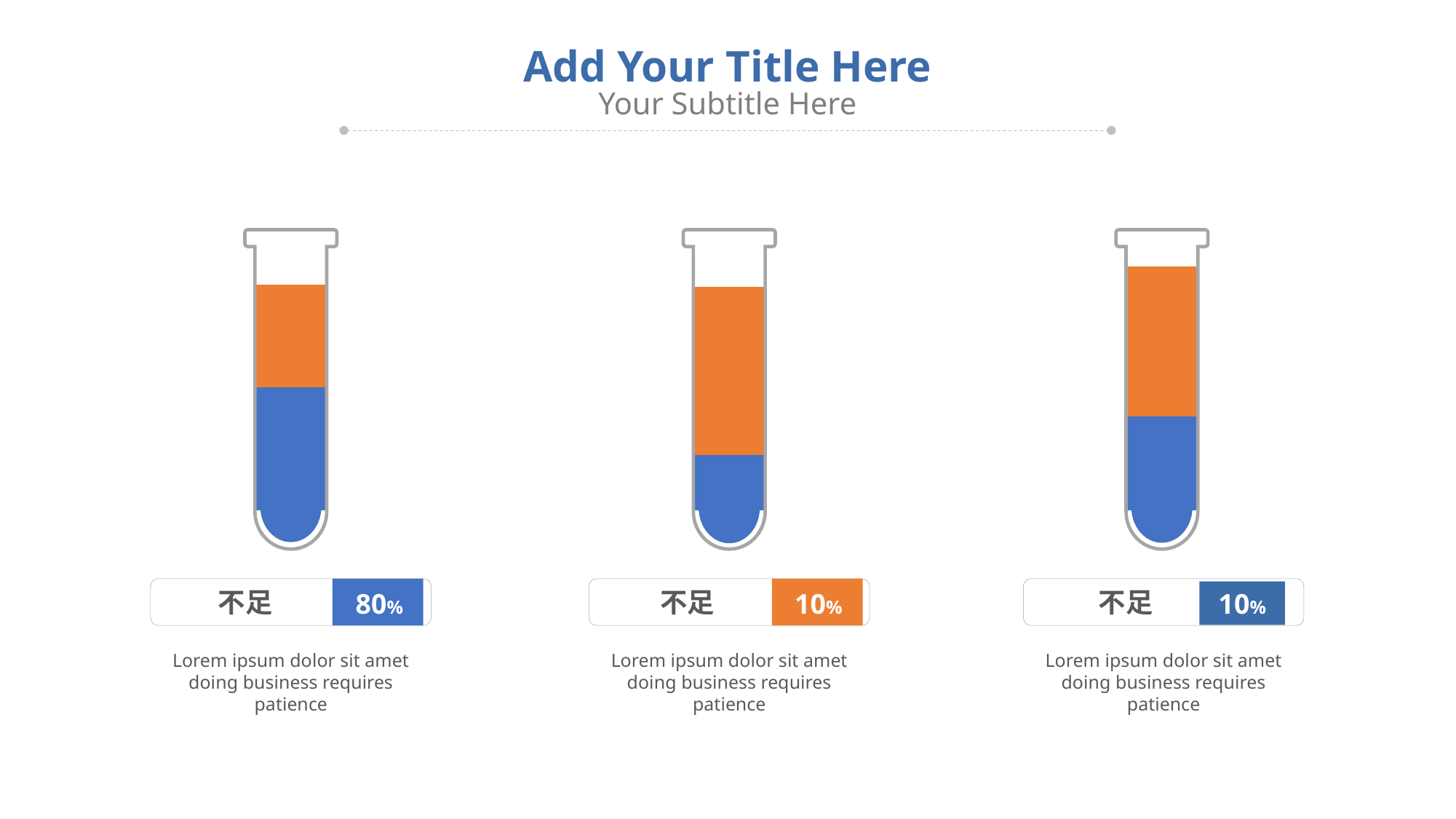
What percentage is printed in the label below the left test tube? 80% What is the difference between the percentage printed under the left test tube and the percentage printed under the middle test tube? 70% How many test tubes are shown on the slide? 3 What Chinese text appears in each label box beneath the test tubes? 不足 What percentage is printed in the label below the middle test tube? 10% Which test tube has the highest percentage printed in its label? the left one What colour is the percentage box in the label under the middle test tube? orange Which is larger, the percentage printed under the left test tube or the one under the middle test tube? the left one (80%) Is the percentage printed under the left test tube greater or less than 50%? greater What percentage is printed in the label below the right test tube? 10%